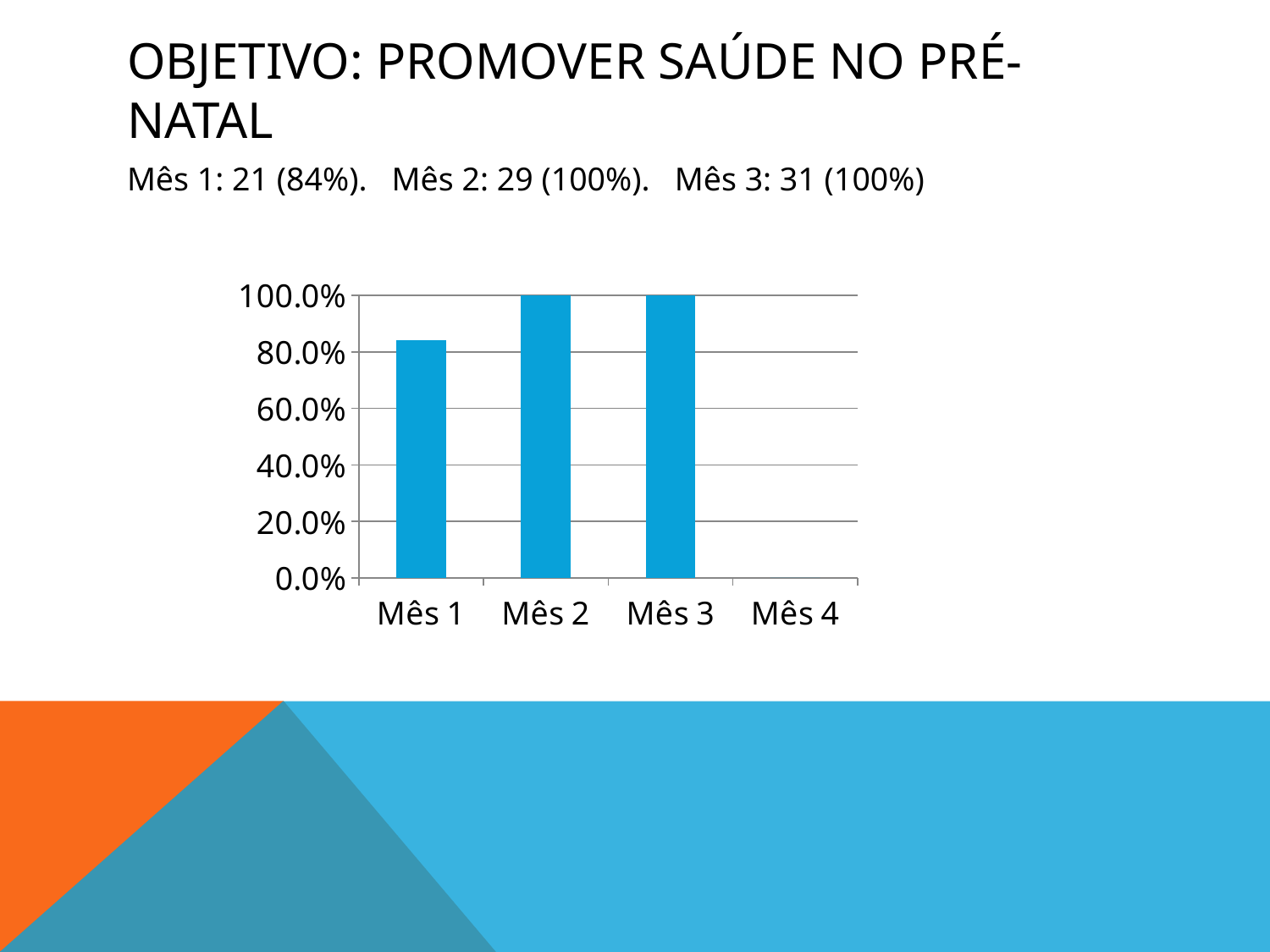
Which is larger, the value for Mês 1 or the value for Mês 2? Mês 2 What is the difference between the value for Mês 2 and the value for Mês 1? 16% What kind of chart is shown on the slide? bar chart Which category on the x axis has no bar plotted? Mês 4 What is the value for Mês 1 in the chart? 84% Is the value for Mês 1 greater or less than 100.0%? less How many categories are shown on the x axis of the chart? 4 What is the value for Mês 2 in the chart? 100% Which category has the lowest bar among those with a plotted bar? Mês 1 Is the value for Mês 1 greater or less than 80.0%? greater Do the values rise or fall from Mês 1 to Mês 2? rise What is the value for Mês 3 in the chart? 100%